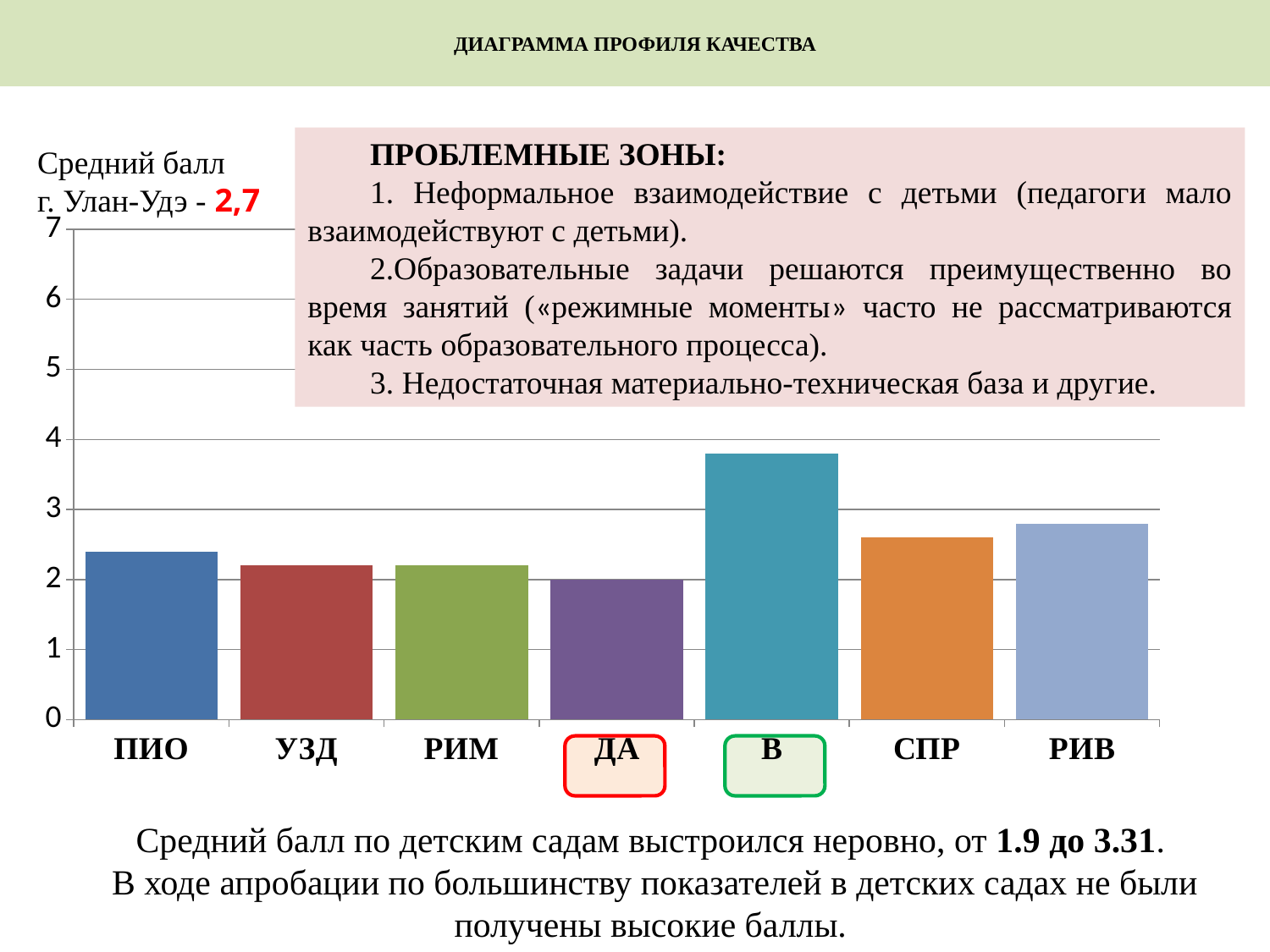
Is the value for В greater or less than 4? less Which category has the lowest bar? ДА Is the value for В greater or less than 3? greater What kind of chart is shown on the slide? bar chart Which category has the highest bar? В What is the title at the top of the slide? ДИАГРАММА ПРОФИЛЯ КАЧЕСТВА Which is larger, the value for В or the value for ПИО? В How many categories are plotted on the chart? 7 Is the value for ДА greater or less than 3? less Which is larger, the value for РИВ or the value for УЗД? РИВ Which category label is outlined in green below the chart? В